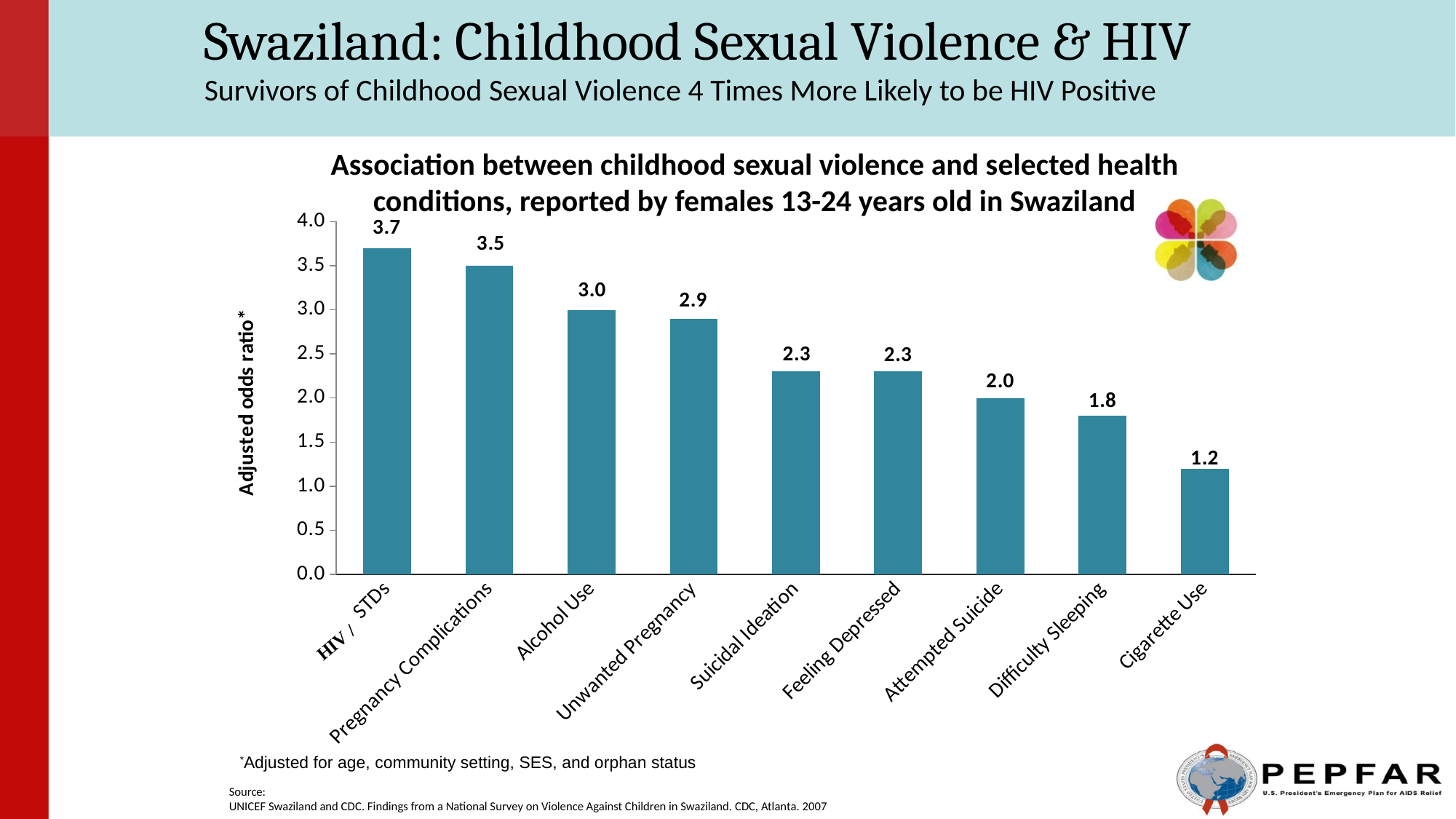
What is the adjusted odds ratio for HIV / STDs? 3.7 What is the adjusted odds ratio for Attempted Suicide? 2.0 Which health condition has the lowest adjusted odds ratio? Cigarette Use Which health condition has the highest adjusted odds ratio? HIV / STDs What is the difference between the adjusted odds ratios for Alcohol Use and Difficulty Sleeping? 1.2 Do the adjusted odds ratios rise or fall from left to right across the chart? Fall What is the label of the vertical axis? Adjusted odds ratio* What is the adjusted odds ratio for Pregnancy Complications? 3.5 What is the adjusted odds ratio for Cigarette Use? 1.2 Which has a larger adjusted odds ratio, Unwanted Pregnancy or Feeling Depressed? Unwanted Pregnancy How many health conditions are shown on the chart? 9 What kind of chart is shown on the slide? Bar chart